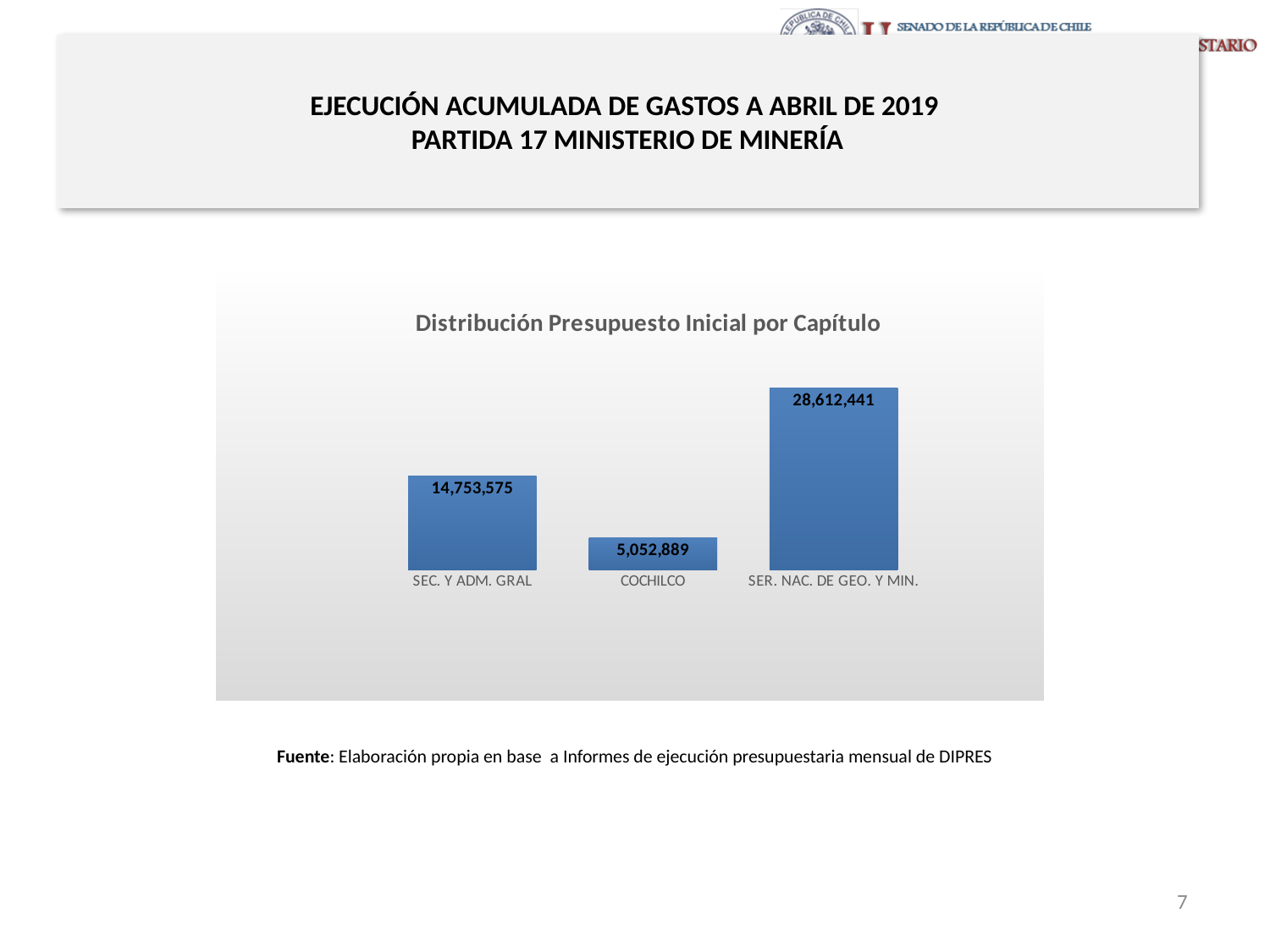
What is the total of the three values shown in the chart? 48,418,905 What kind of chart is shown on the slide? Bar chart Which category has the lowest value in the chart? COCHILCO What is the value for COCHILCO in the chart? 5,052,889 Which category has the highest value in the chart? SER. NAC. DE GEO. Y MIN. What is the difference between the values for SER. NAC. DE GEO. Y MIN. and SEC. Y ADM. GRAL? 13,858,866 What is the title of the chart? Distribución Presupuesto Inicial por Capítulo What is the value for SEC. Y ADM. GRAL in the chart? 14,753,575 Which is larger, the value for SEC. Y ADM. GRAL or the value for COCHILCO? SEC. Y ADM. GRAL What is the value for SER. NAC. DE GEO. Y MIN. in the chart? 28,612,441 How many categories are shown in the chart? 3 What is the difference between the values for SEC. Y ADM. GRAL and COCHILCO? 9,700,686